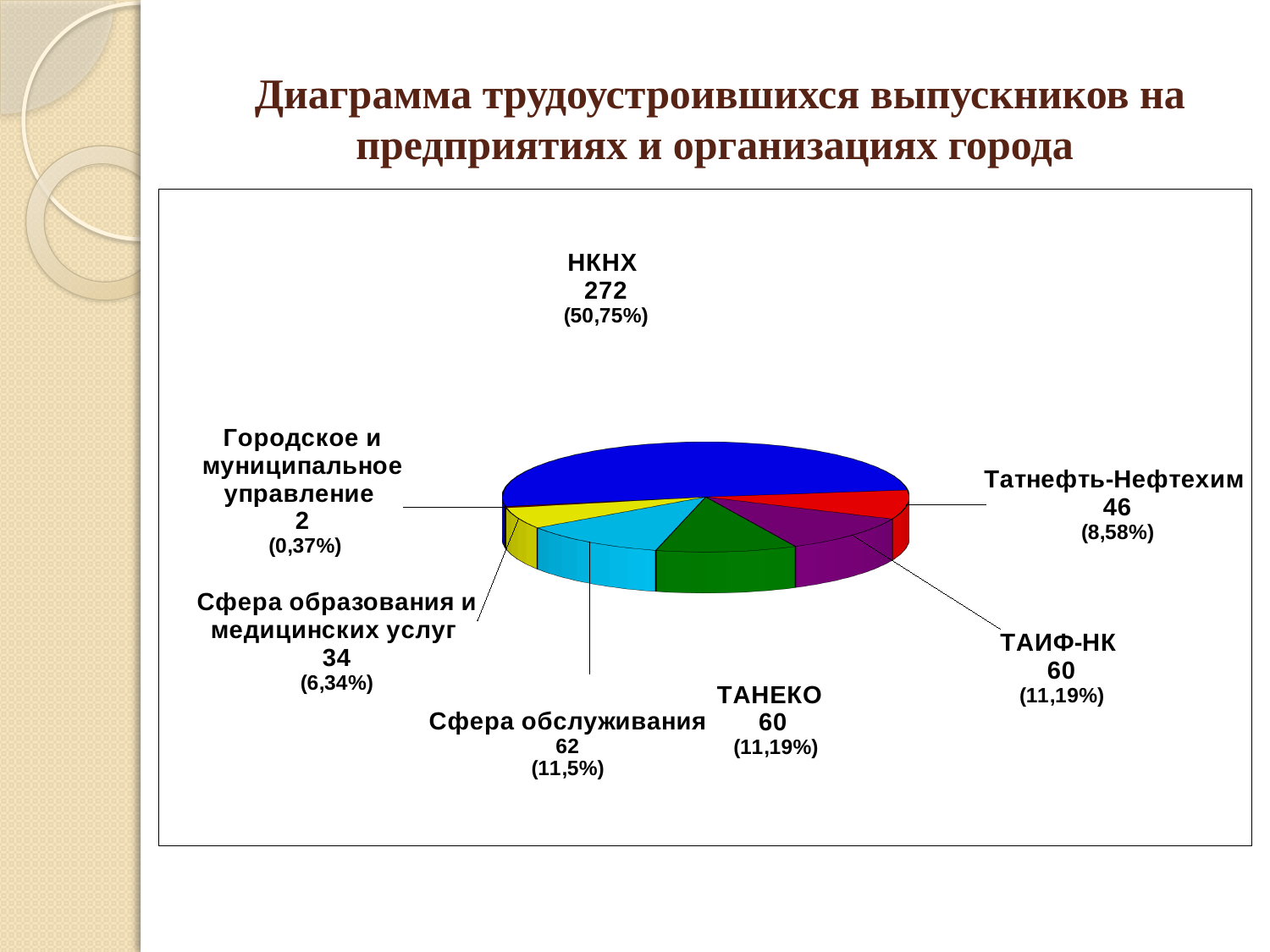
What type of chart is shown on the slide? pie chart Which is larger, the value for Сфера обслуживания or the value for Татнефть-Нефтехим? Сфера обслуживания Which category has the highest value? НКНХ What is the value for Сфера образования и медицинских услуг? 34 What percentage is shown for Сфера обслуживания? 11,5% How many graduates were employed at НКНХ? 272 Which category has the lowest value? Городское и муниципальное управление What colour is the НКНХ slice? blue What share of the pie does НКНХ represent? 50,75% How many categories does the pie chart have? 7 How many graduates were employed at Татнефть-Нефтехим? 46 What is the difference between the values for НКНХ and ТАНЕКО? 212